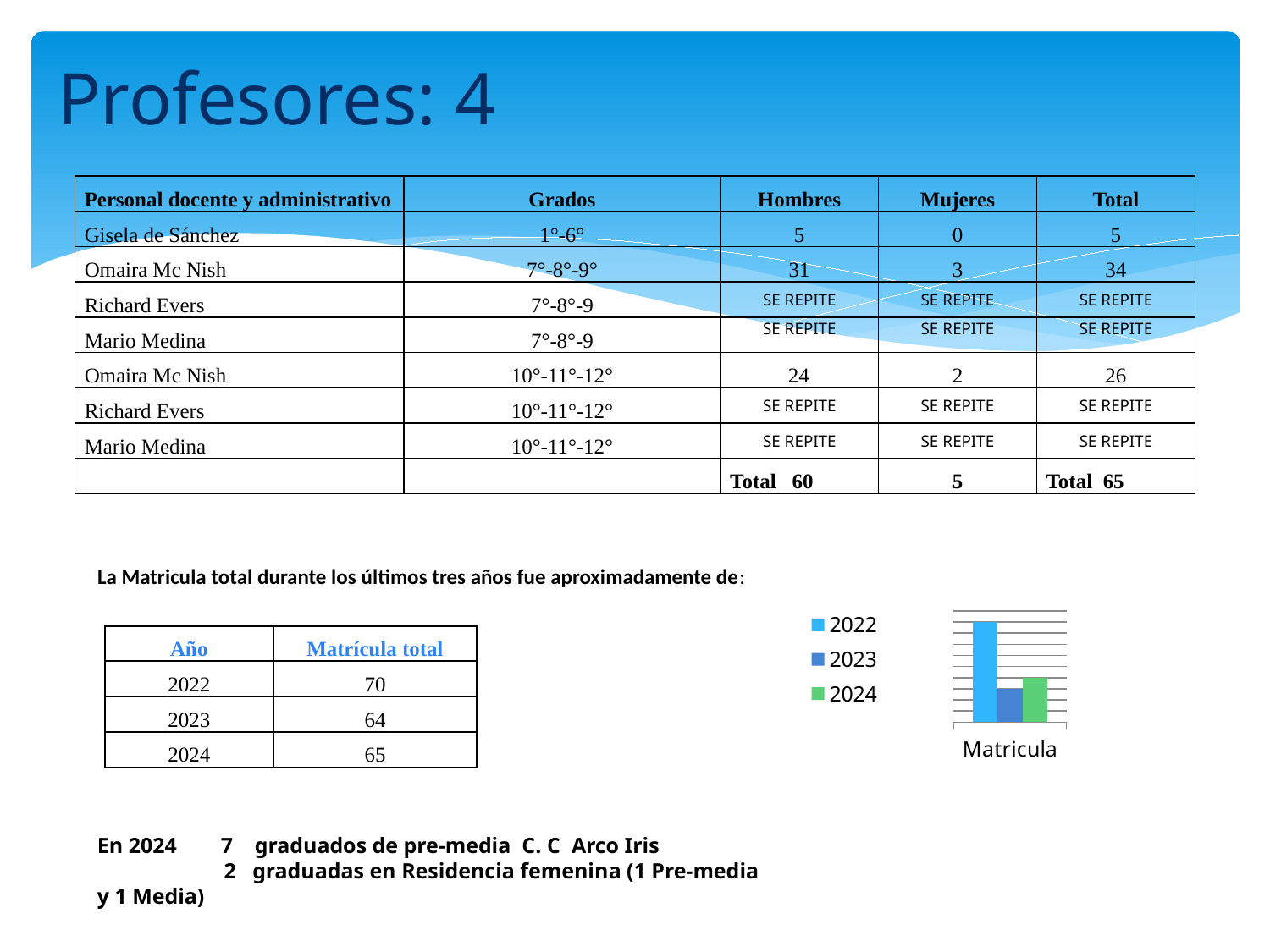
What kind of chart is shown on the slide? bar chart How many categories are shown on the x axis of the chart? 1 How many series does the chart's legend list? 3 What is the category label shown under the bars in the chart? Matricula In the chart, which bar is taller, 2022 or 2024? 2022 Which series has the tallest bar in the chart? 2022 In the chart, is the bar for 2022 taller or shorter than the bar for 2023? taller Which series is drawn in green in the chart? 2024